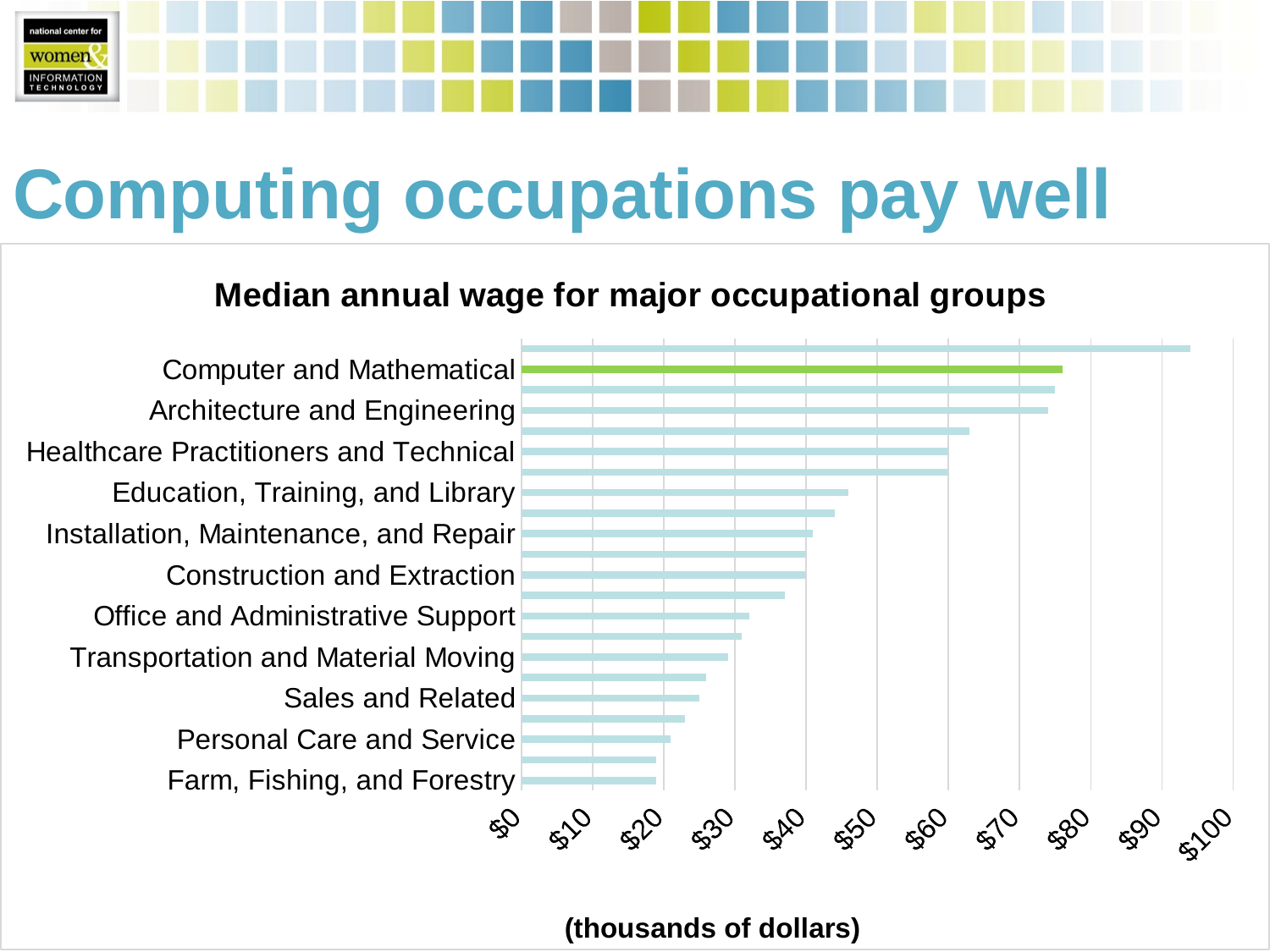
Which category's bar is highlighted in green? Computer and Mathematical Is the value for Architecture and Engineering greater or less than $70? greater What kind of chart is shown on the slide? bar chart What is the title of the chart? Median annual wage for major occupational groups Is the value for Office and Administrative Support greater or less than $40? less Which is larger, the value for Office and Administrative Support or the value for Sales and Related? Office and Administrative Support Is the value for Computer and Mathematical greater or less than $70? greater Do the bar values increase or decrease going from the top of the chart to the bottom? decrease Which is larger, the value for Computer and Mathematical or the value for Healthcare Practitioners and Technical? Computer and Mathematical